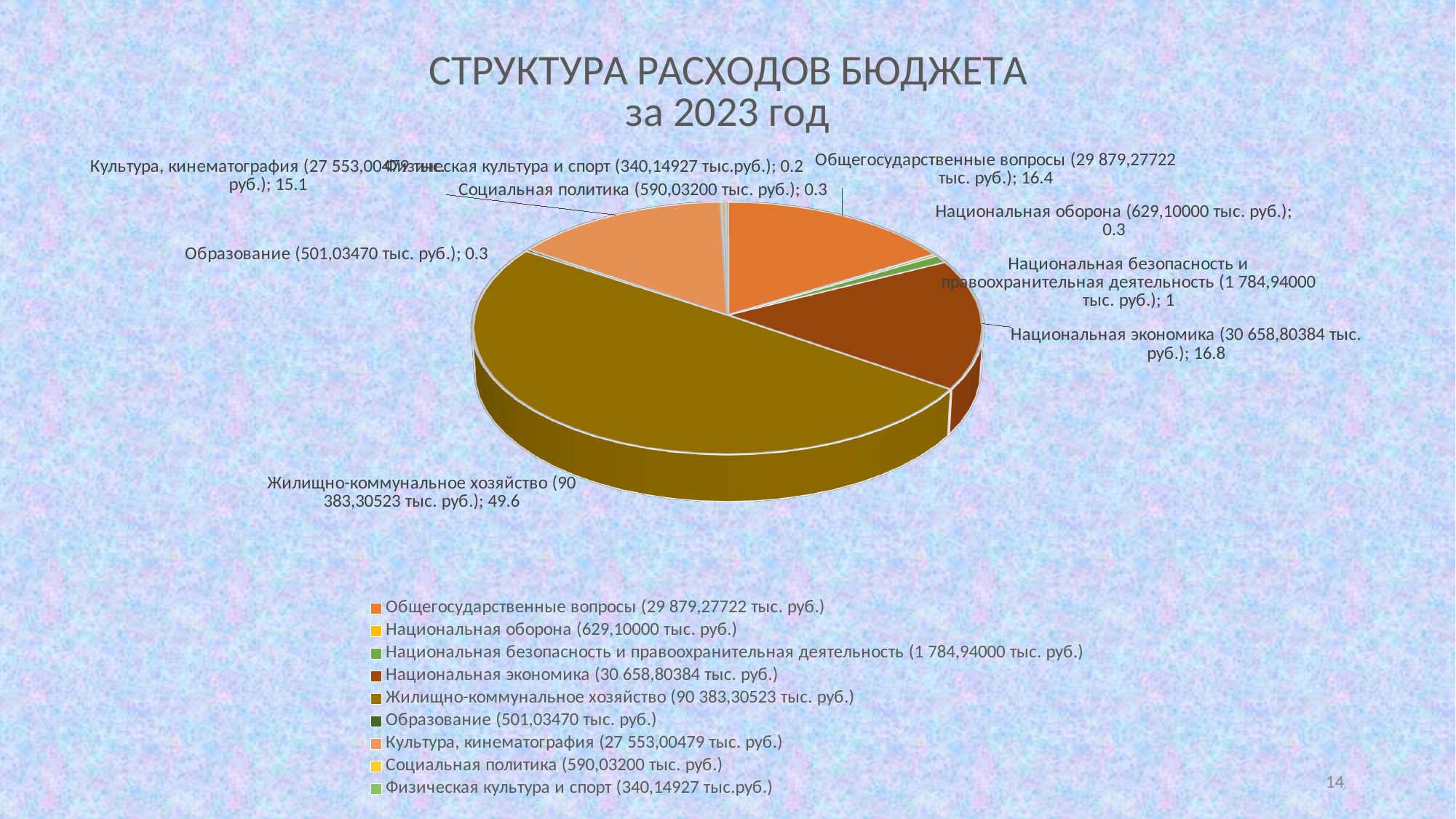
What share of the pie does Культура, кинематография have? 15.1 What is the value shown for Национальная экономика in тыс. руб.? 30 658,80384 Which has the larger share: Национальная экономика or Общегосударственные вопросы? Национальная экономика What is the title of the chart? СТРУКТУРА РАСХОДОВ БЮДЖЕТА за 2023 год What is the value shown for Общегосударственные вопросы in тыс. руб.? 29 879,27722 What share of the pie does Национальная безопасность и правоохранительная деятельность have? 1 What share of the pie does Жилищно-коммунальное хозяйство have? 49.6 Which category has the largest share of the pie? Жилищно-коммунальное хозяйство What kind of chart is shown on the slide? pie chart What is the difference in percentage share between Жилищно-коммунальное хозяйство and Национальная экономика? 32.8 Which category has the smallest share of the pie? Физическая культура и спорт How many categories does the pie chart have? 9